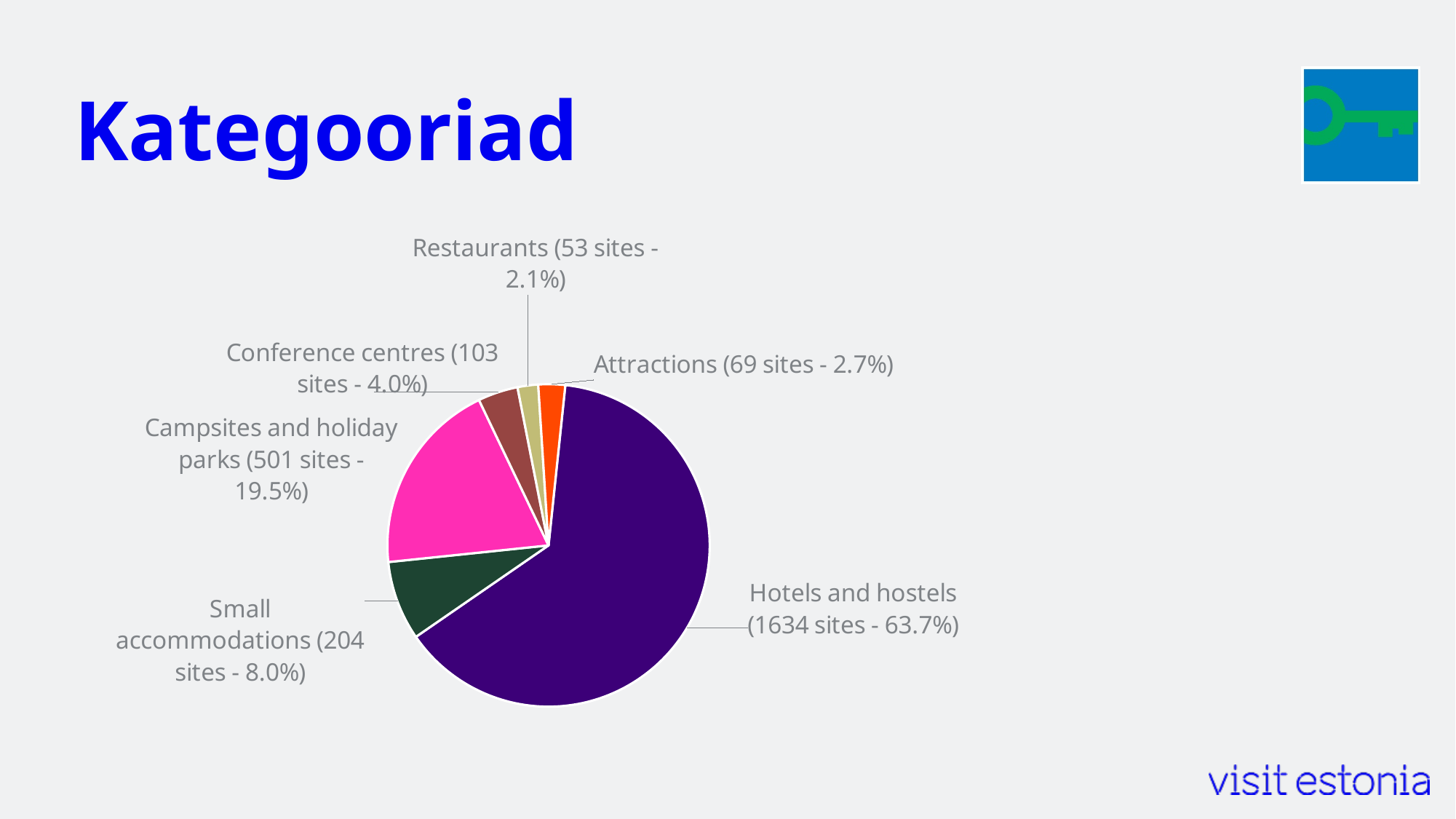
What is the title of the slide containing the pie chart? Kategooriad Which has more sites, Campsites and holiday parks or Small accommodations? Campsites and holiday parks How many sites are in the Small accommodations category? 204 sites Which category has the largest slice of the pie? Hotels and hostels Which category has the smallest slice of the pie? Restaurants What is the difference in sites between Hotels and hostels and Campsites and holiday parks? 1133 sites How many sites are in the Hotels and hostels category? 1634 sites What percentage of the pie is Conference centres? 4.0% How many categories does the pie chart show? 6 What kind of chart is shown on the slide? Pie chart What share of the pie does Campsites and holiday parks represent? 19.5% How many more sites are there in Attractions than in Restaurants? 16 sites